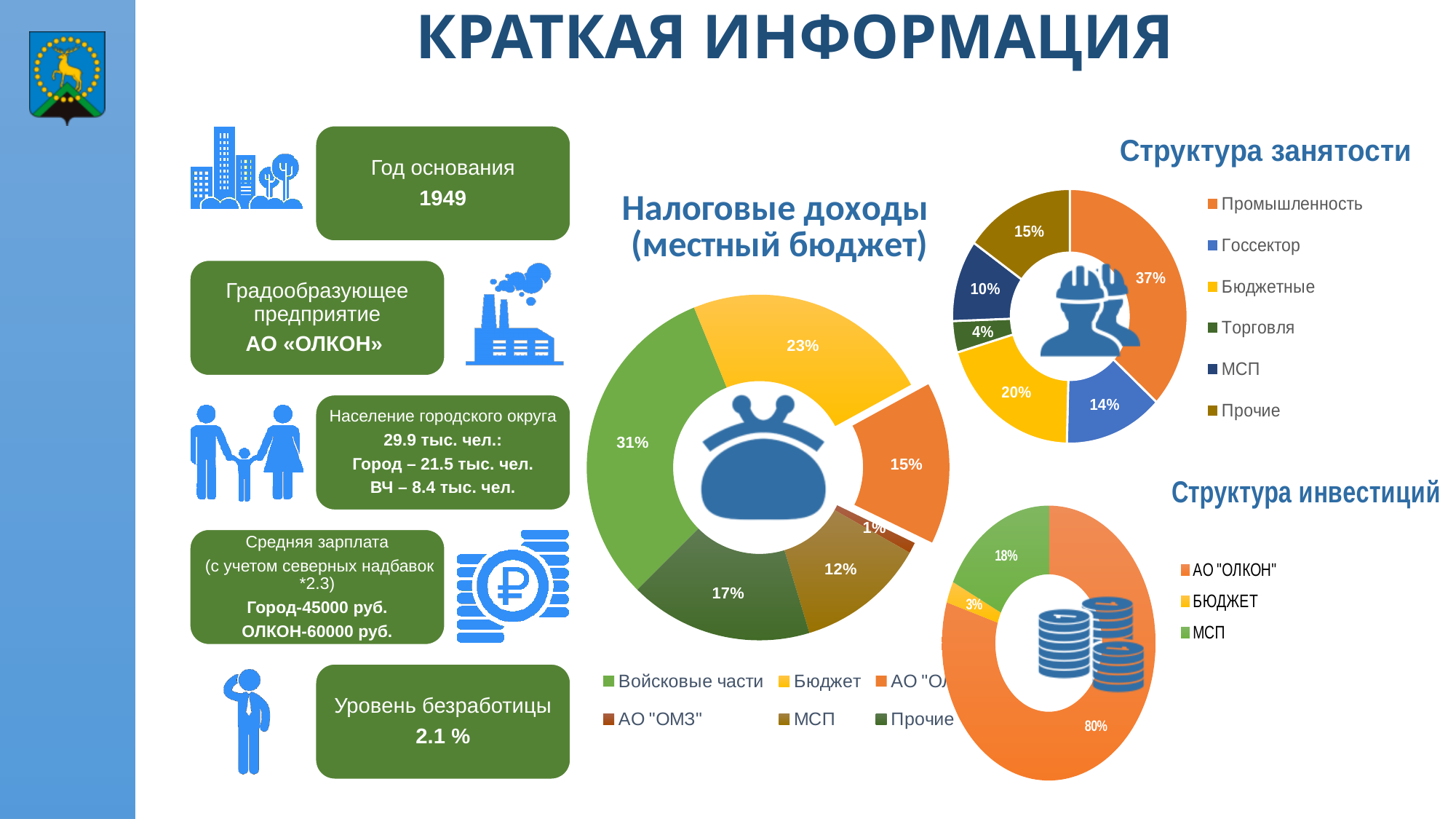
In the 'Структура инвестиций' chart, what is the difference between МСП and БЮДЖЕТ? 15% In the 'Структура занятости' chart, what share is Промышленность? 37% In the 'Структура занятости' chart, which is larger, Госсектор or Бюджетные? Бюджетные In the 'Налоговые доходы (местный бюджет)' chart, what share is Бюджет? 23% In the 'Структура занятости' chart, which category has the smallest share? Торговля In the 'Налоговые доходы (местный бюджет)' chart, what share is Войсковые части? 31% In the 'Налоговые доходы (местный бюджет)' chart, which category has the smallest share? АО "ОМЗ" In the 'Структура инвестиций' chart, what share is АО "ОЛКОН"? 80% In the 'Налоговые доходы (местный бюджет)' chart, what is the difference between Прочие and МСП? 5% What kind of chart is 'Структура занятости'? Doughnut chart How many categories does the legend of the 'Структура занятости' chart list? 6 In the 'Налоговые доходы (местный бюджет)' chart, which category has the largest share? Войсковые части